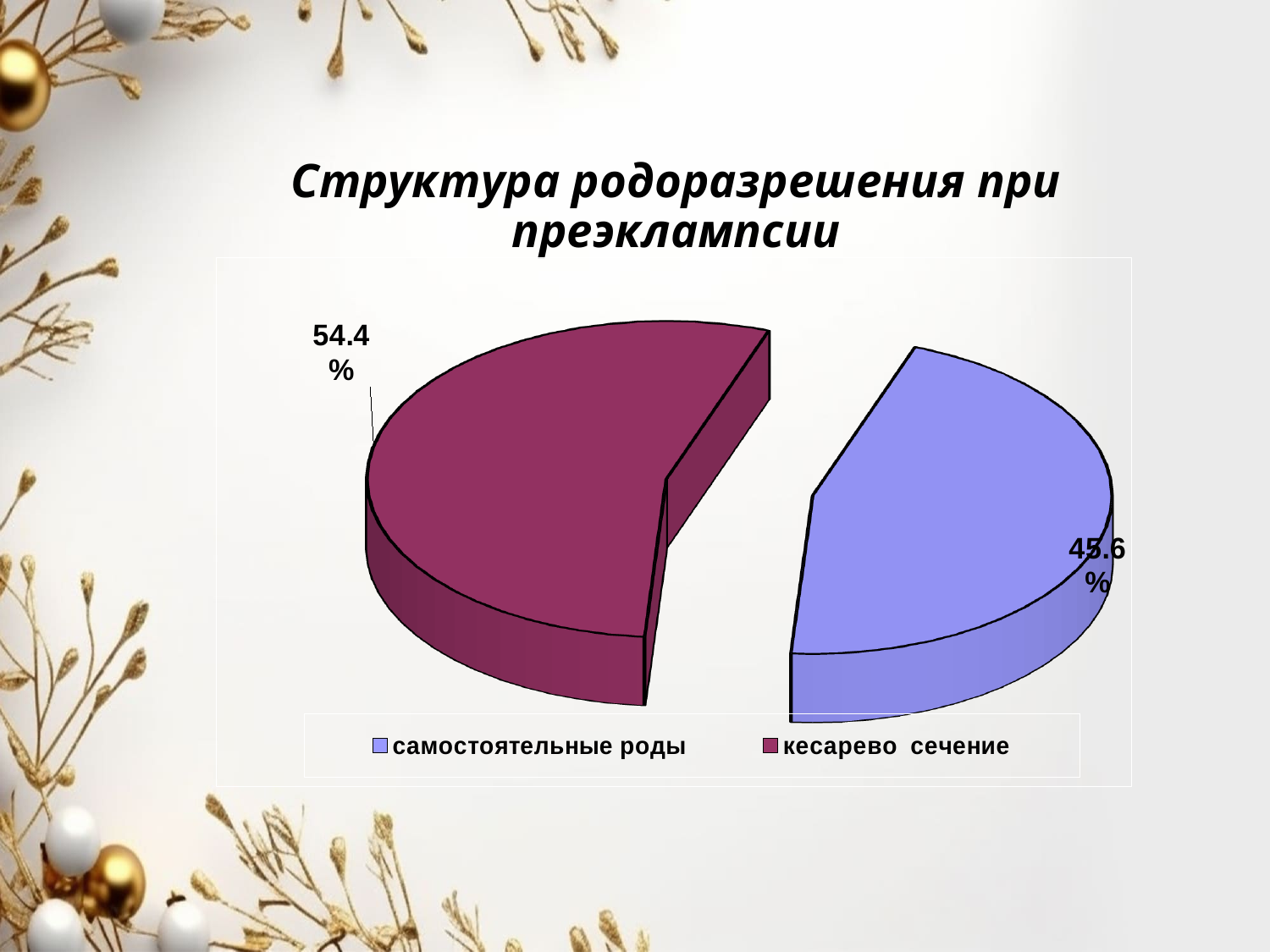
What is the title of the chart? Структура родоразрешения при преэклампсии What kind of chart is shown on the slide? Pie chart What colour is the slice for самостоятельные роды? Blue Which category has the largest share of the pie? кесарево сечение How many slices does the pie chart have? 2 What is the value for кесарево сечение? 54.4% How many entries does the legend list? 2 Which is larger, the share for самостоятельные роды or the share for кесарево сечение? кесарево сечение What share of the pie does самостоятельные роды represent? 45.6% Which category has the smallest share of the pie? самостоятельные роды What is the difference between the share for кесарево сечение and the share for самостоятельные роды? 8.8% What is the value for самостоятельные роды? 45.6%